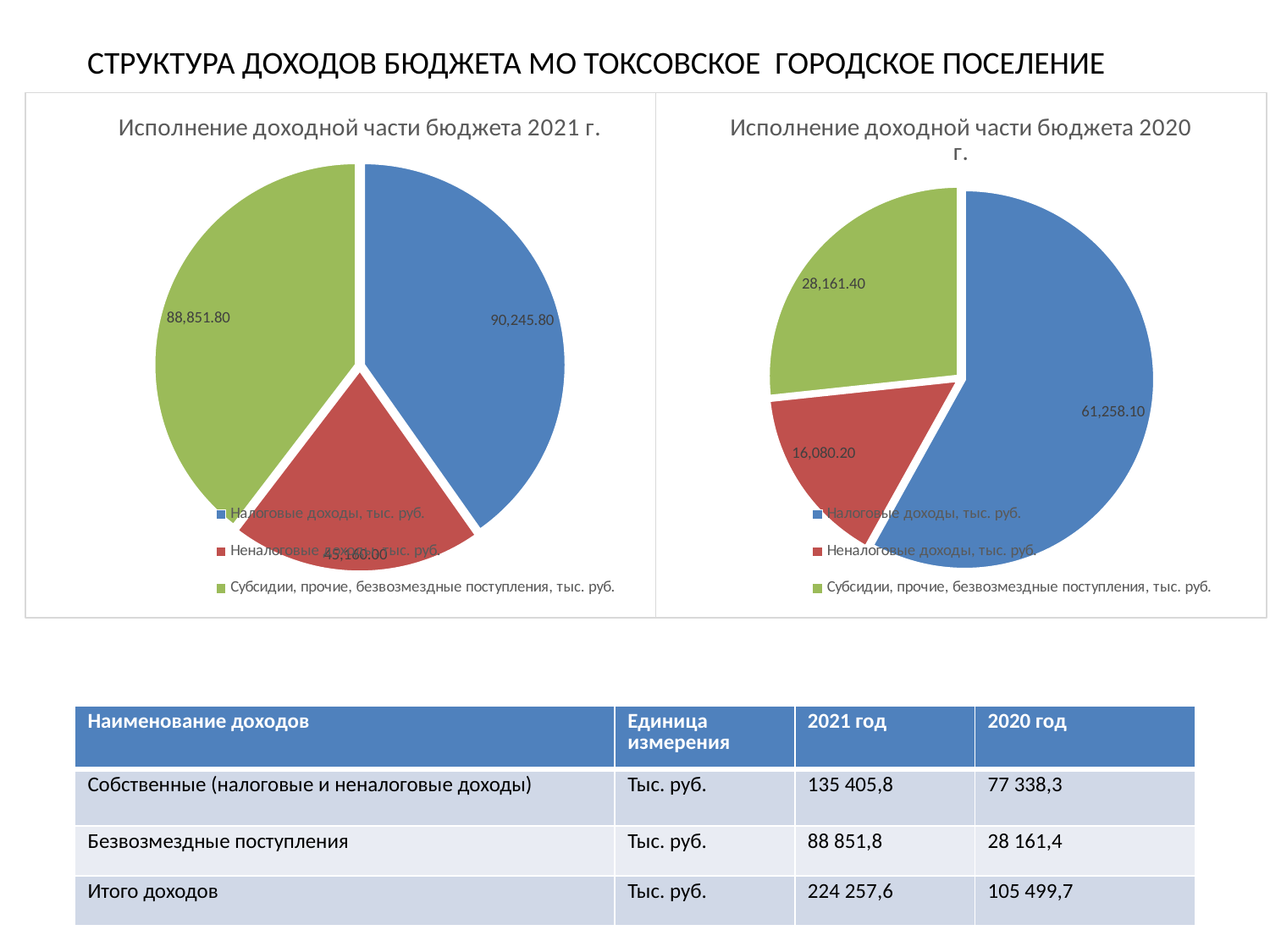
In the chart "Исполнение доходной части бюджета 2020 г.", what is the difference between Налоговые доходы and Субсидии, прочие, безвозмездные поступления? 33,096.70 How many slices does the chart "Исполнение доходной части бюджета 2020 г." have? 3 In the chart "Исполнение доходной части бюджета 2021 г.", which category has the smallest slice? Неналоговые доходы, тыс. руб. What kind of chart is "Исполнение доходной части бюджета 2021 г."? Pie chart In the chart "Исполнение доходной части бюджета 2020 г.", which category has the smallest slice? Неналоговые доходы, тыс. руб. In the chart "Исполнение доходной части бюджета 2020 г.", which category has the largest slice? Налоговые доходы, тыс. руб. In the chart "Исполнение доходной части бюджета 2021 г.", what is the value for Налоговые доходы? 90,245.80 In the chart "Исполнение доходной части бюджета 2020 г.", what is the value for Неналоговые доходы? 16,080.20 In the chart "Исполнение доходной части бюджета 2021 г.", which is larger: Налоговые доходы or Субсидии, прочие, безвозмездные поступления? Налоговые доходы, тыс. руб. In the chart "Исполнение доходной части бюджета 2021 г.", what is the value for Субсидии, прочие, безвозмездные поступления? 88,851.80 In the chart "Исполнение доходной части бюджета 2020 г.", what is the value for Налоговые доходы? 61,258.10 In the chart "Исполнение доходной части бюджета 2020 г.", what is the value for Субсидии, прочие, безвозмездные поступления? 28,161.40